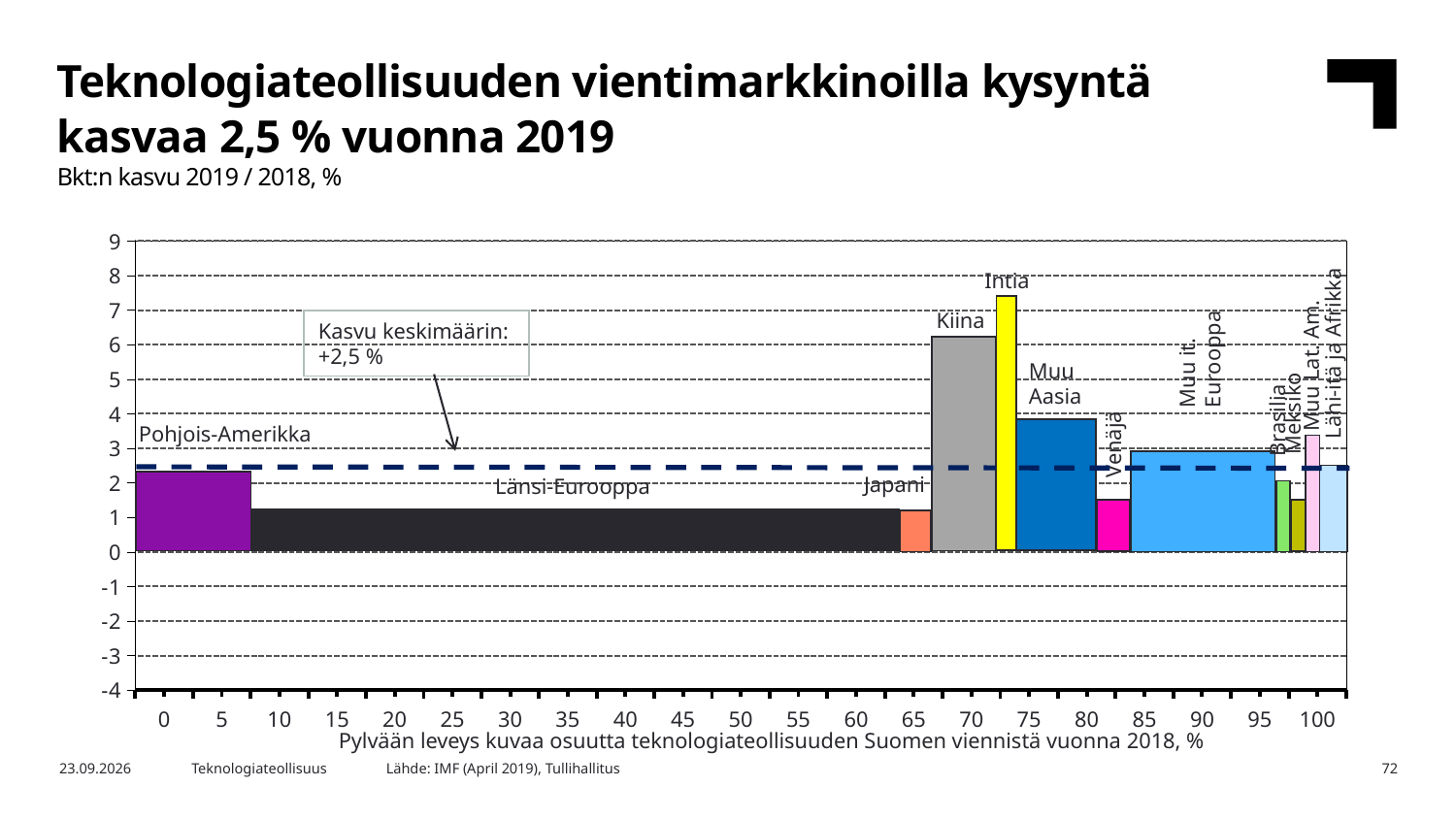
Is the value for Kiina greater or less than 5? greater Is the value for Venäjä greater or less than 2? less Is the value for Länsi-Eurooppa greater or less than 2? less Which has the larger value, Kiina or Muu Aasia? Kiina Which has the larger value, Pohjois-Amerikka or Japani? Pohjois-Amerikka How many regions (bars) are labelled in the chart? 12 According to the note under the x axis, what does the width of each bar represent? Share of Finnish technology industry exports in 2018, % What kind of chart is shown on the slide? bar chart What is the average growth (Kasvu keskimäärin) shown on the chart? +2,5 % Which region has the highest GDP growth value in the chart? Intia